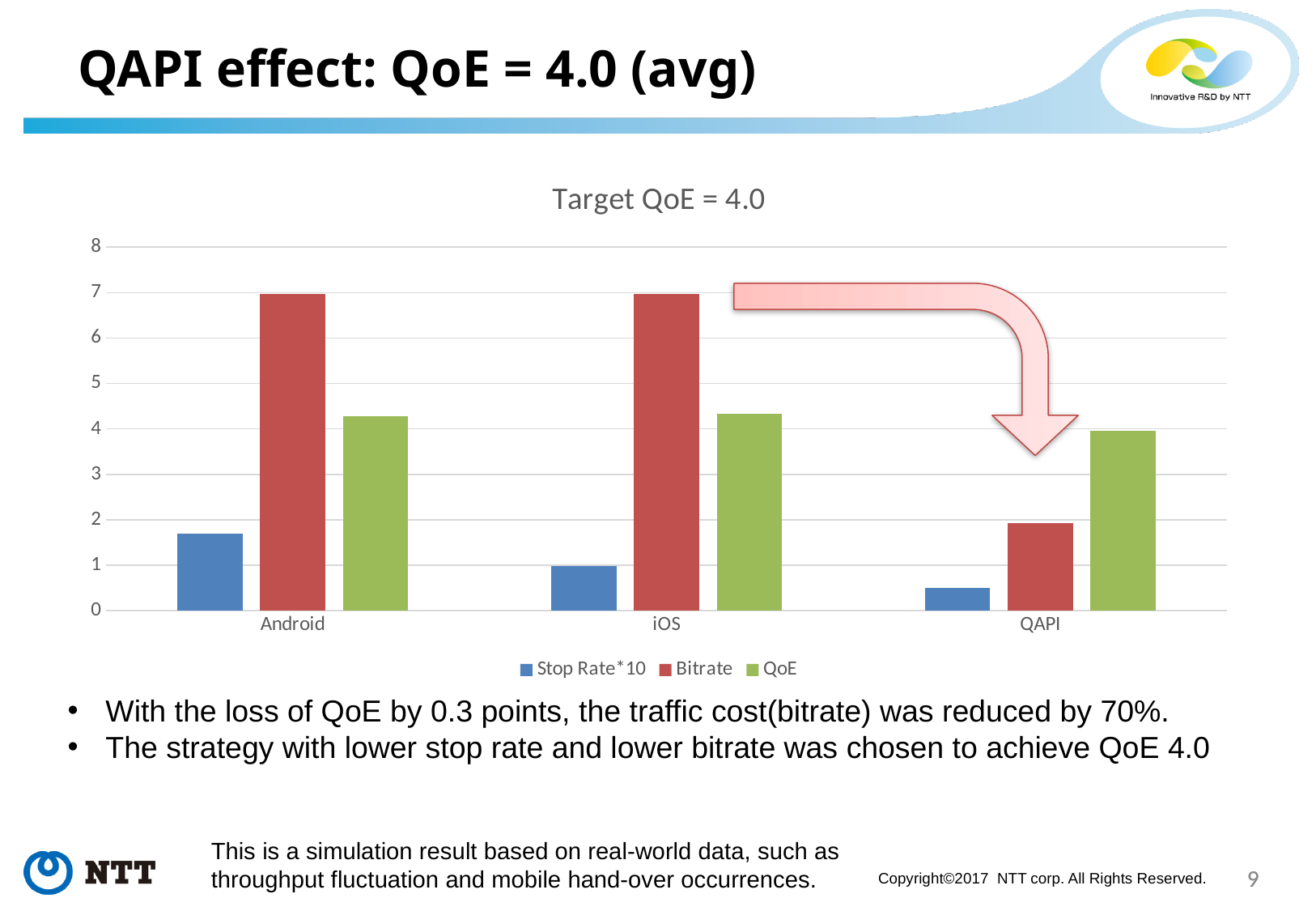
Which category has the highest Stop Rate*10 value? Android What is the title of the chart? Target QoE = 4.0 What kind of chart is shown on the slide? bar chart Which category has the lowest QoE value? QAPI Is the Bitrate value for QAPI greater or less than 3? less How many categories are shown on the x axis of the chart? 3 How many series does the chart legend list? 3 Is the Stop Rate*10 value for QAPI greater or less than 1? less Which category has the lowest Bitrate value? QAPI Does the Stop Rate*10 value rise or fall across the categories from Android to QAPI? fall Is the Bitrate value for Android greater or less than 6? greater Which is larger, the Bitrate for iOS or the Bitrate for QAPI? Bitrate for iOS